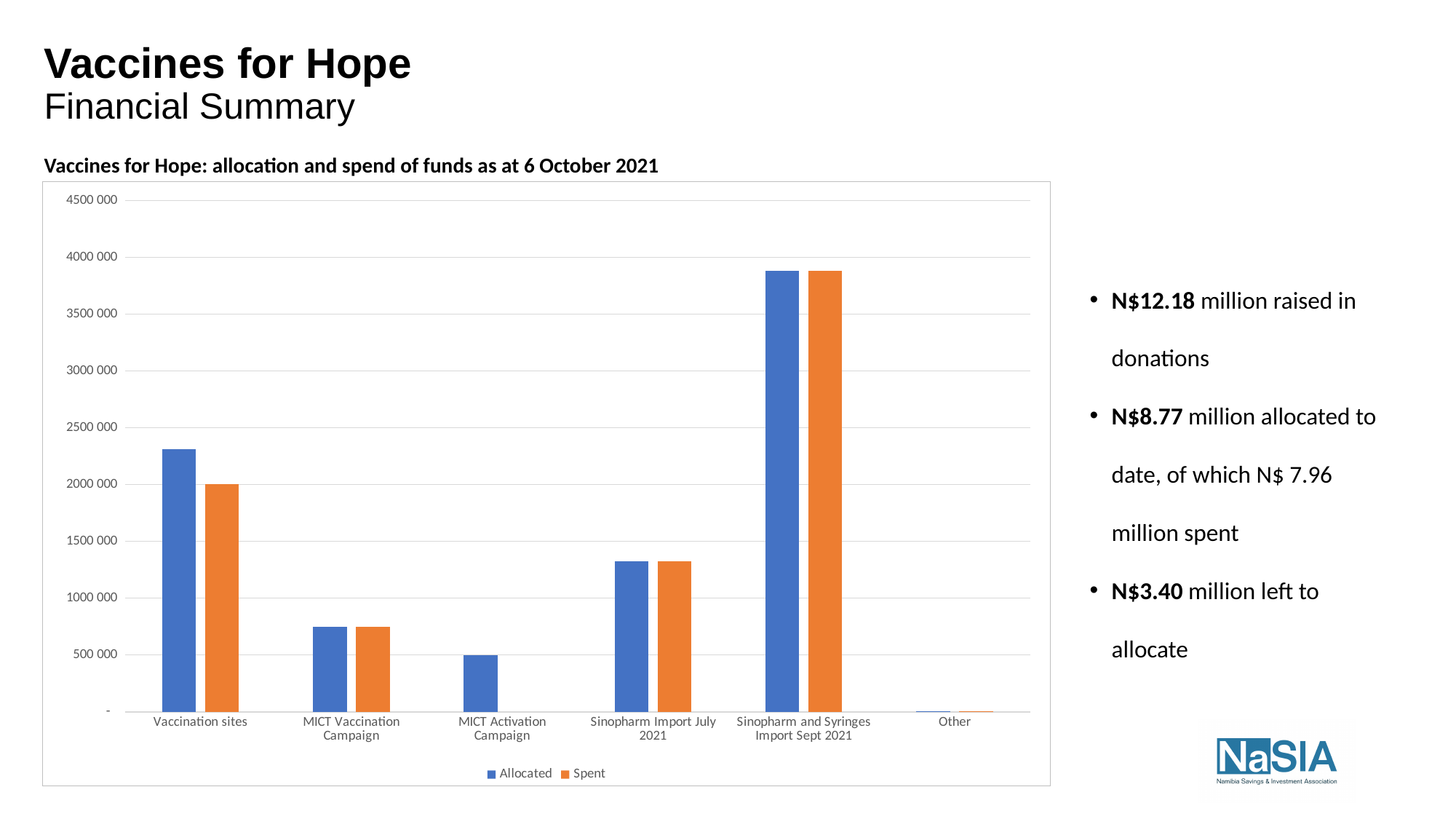
What kind of chart is shown on the slide? Bar chart Is the Spent value for MICT Vaccination Campaign greater or less than 1000 000? less Which category has the lowest Allocated value? Other Which category has the highest Allocated value? Sinopharm and Syringes Import Sept 2021 How many series does the chart legend list? 2 For Vaccination sites, which is larger: the Allocated value or the Spent value? Allocated How many categories are shown on the x axis of the chart? 6 Is the Spent value for Sinopharm Import July 2021 greater or less than 1500 000? less Which has the larger Allocated value: Sinopharm Import July 2021 or MICT Vaccination Campaign? Sinopharm Import July 2021 Is the Allocated value for Sinopharm and Syringes Import Sept 2021 greater or less than 3500 000? greater What is the title of the chart? Vaccines for Hope: allocation and spend of funds as at 6 October 2021